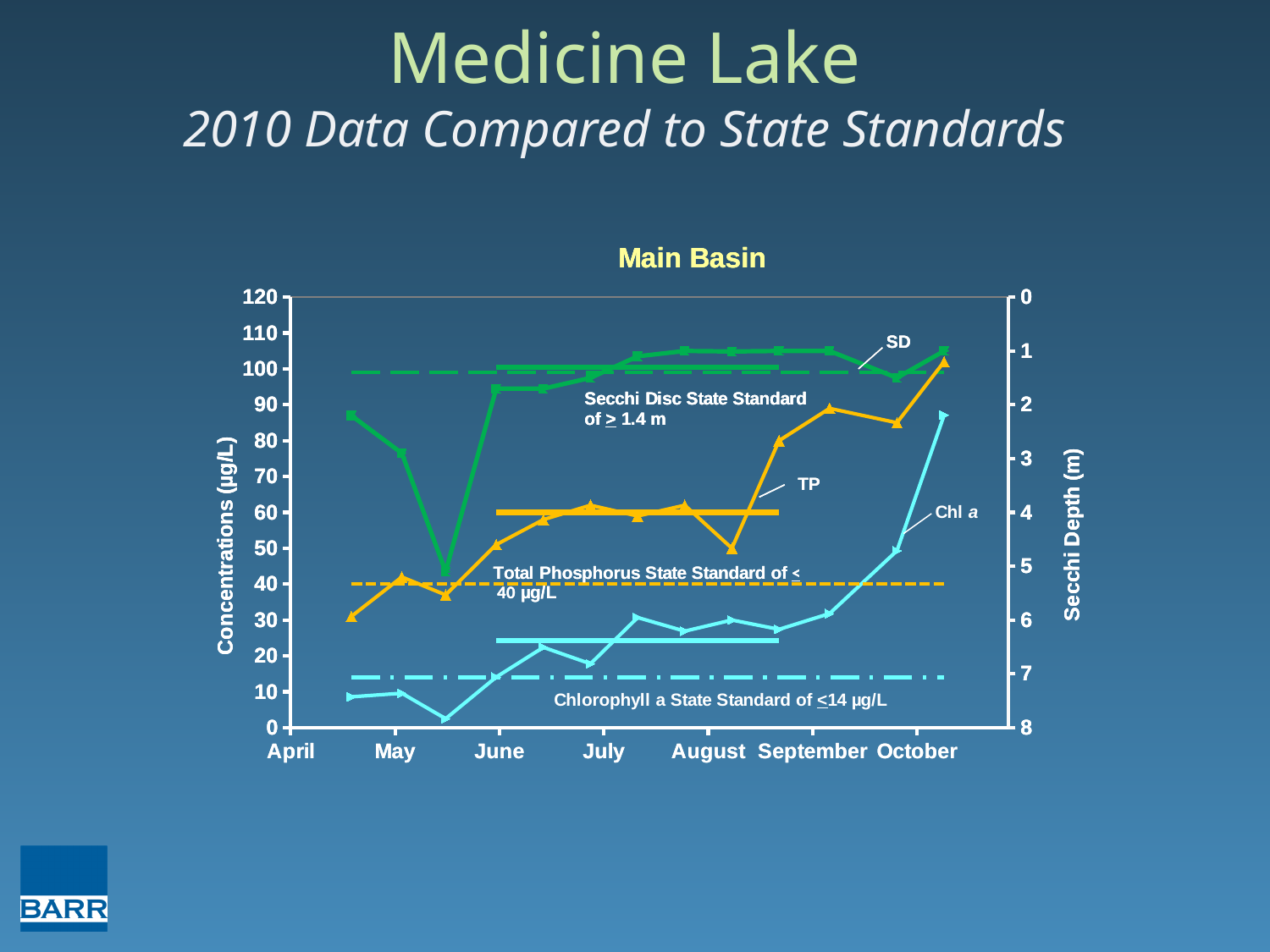
What type of chart is shown on the slide? line chart What is the maximum value shown on the right-hand Secchi Depth axis? 8 What is the title of the chart? Main Basin Does the Chl a line rise or fall from August to October? rise Is the TP value in October greater or less than 90 µg/L? greater Is the Chl a value in October greater or less than 80 µg/L? greater Is the Chl a value in mid-May greater or less than 10 µg/L? less How many months are labelled along the x axis of the chart? 7 What is the Chlorophyll a state standard stated on the chart? 14 µg/L What is the Total Phosphorus state standard stated on the chart? 40 µg/L In October, which series has the higher concentration, TP or Chl a? TP